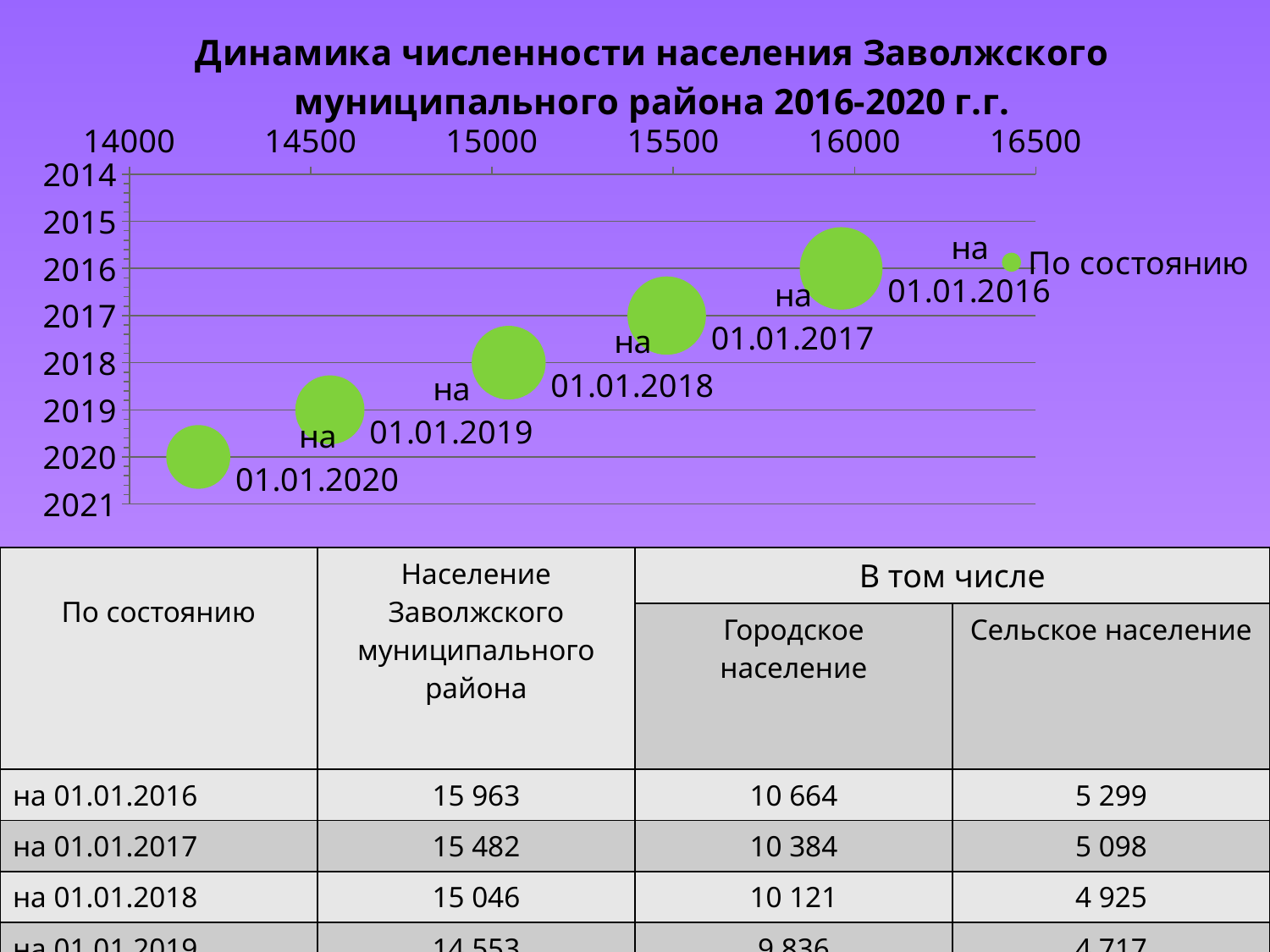
What kind of chart is shown on the slide? bubble chart What is the population value for the bubble labelled 'на 01.01.2016'? 15 963 Which date has the highest population value in the chart? на 01.01.2016 Does the population rise or fall from 01.01.2016 to 01.01.2020? fall What is the population value for the bubble labelled 'на 01.01.2018'? 15 046 What is the difference between the population on 01.01.2016 and on 01.01.2017? 481 Is the population value for 'на 01.01.2020' greater or less than 14500? less What is the population value for the bubble labelled 'на 01.01.2017'? 15 482 How many series does the chart legend list? 1 What is the title of the chart? Динамика численности населения Заволжского муниципального района 2016-2020 г.г. How many bubbles (data points) are plotted in the chart? 5 Which date has the lowest population value in the chart? на 01.01.2020